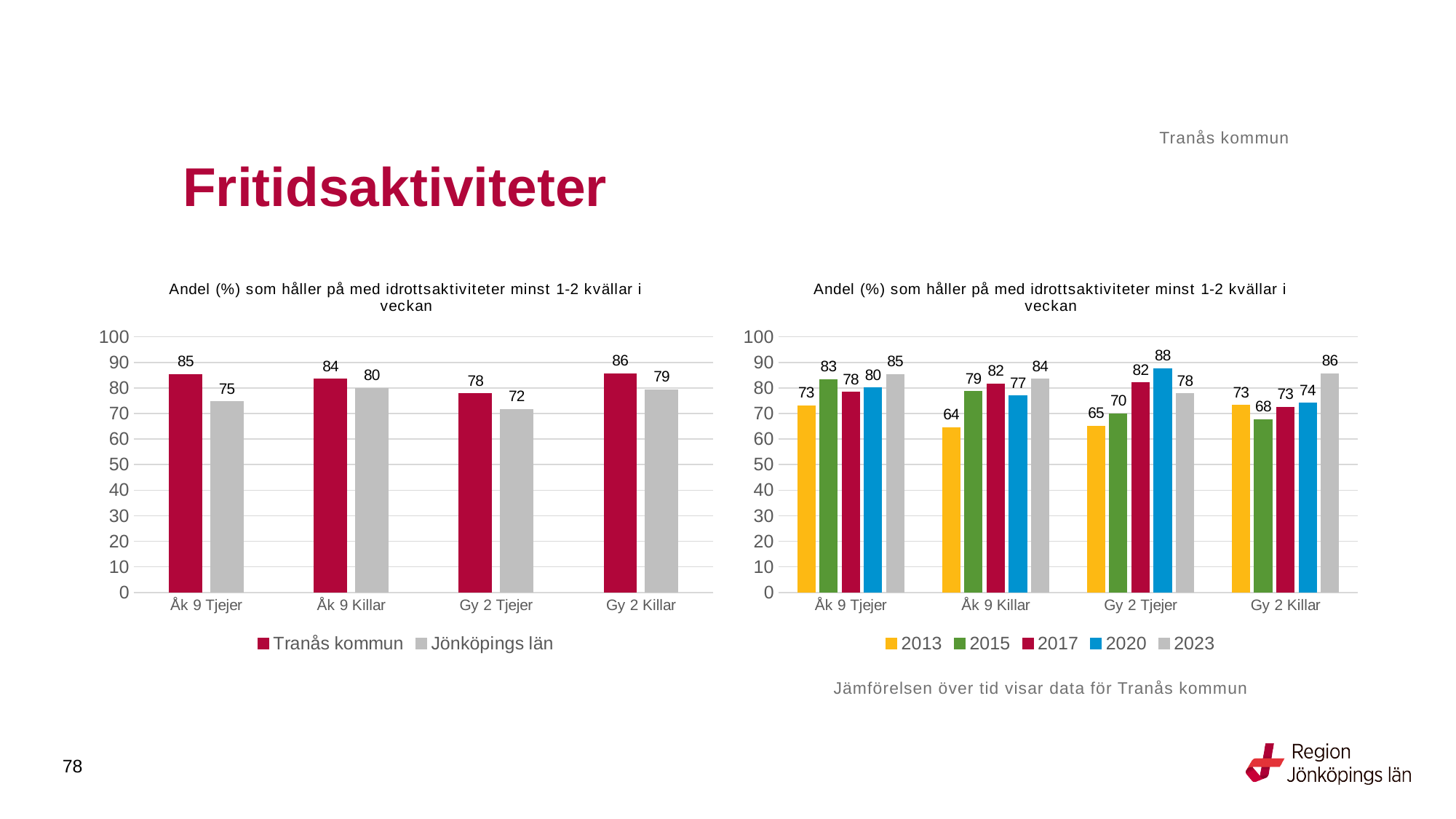
In the right chart, what is the value for 2020 for Gy 2 Tjejer? 88 In the right chart, which is larger for Åk 9 Tjejer: the value for 2015 or the value for 2017? 2015 In the right chart, what is the value for 2013 for Åk 9 Killar? 64 In the left chart, what is the value for Jönköpings län for Åk 9 Killar? 80 In the left chart, what is the value for Tranås kommun for Gy 2 Tjejer? 78 In the right chart, how many series does the legend list? 5 What kind of chart is the right chart? Bar chart In the right chart, which year has the lowest value for Gy 2 Killar? 2015 In the left chart, what is the difference between Tranås kommun and Jönköpings län for Åk 9 Tjejer? 10 In the left chart, which category has the highest value for Tranås kommun? Gy 2 Killar In the left chart, how many series does the legend list? 2 In the left chart, which category has the lowest value for Jönköpings län? Gy 2 Tjejer